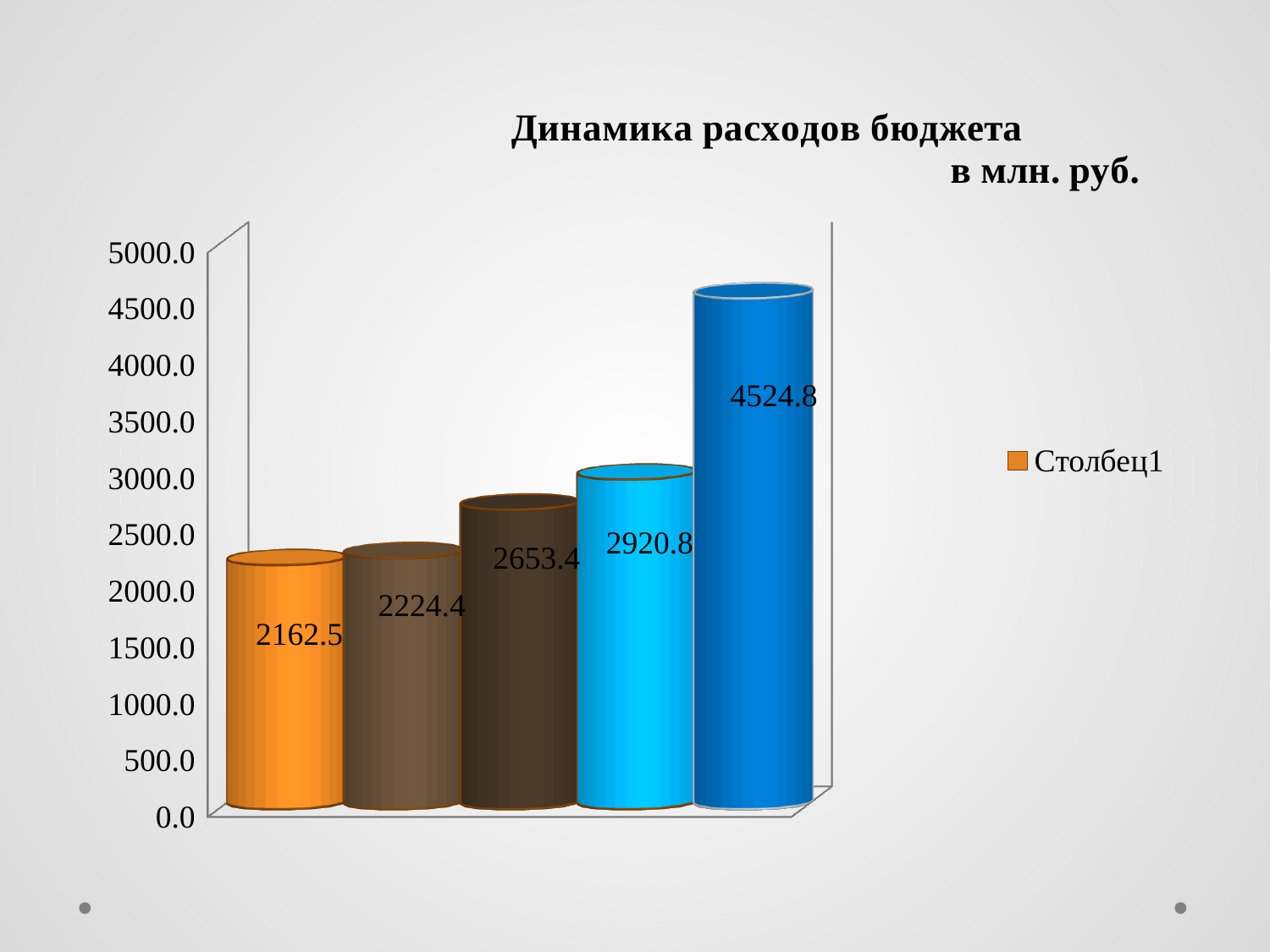
What is the value shown on the dark brown (third) bar? 2653.4 Do the values rise or fall from left to right across the bars? Rise What is the value shown on the light blue (fourth) bar? 2920.8 What is the difference between the value of the rightmost bar and the value of the leftmost bar? 2362.3 Which bar has the lowest value? The orange bar at the far left (2162.5) Which bar has the highest value? The dark blue bar at the far right (4524.8) How many series does the legend list? 1 Which is larger: the value of the second bar (2224.4) or the value of the third bar (2653.4)? The third bar (2653.4) What is the value shown on the first (orange) bar from the left? 2162.5 How many bars are plotted in the chart? 5 What is the value shown on the dark blue bar at the far right? 4524.8 What kind of chart is shown on the slide? Bar chart